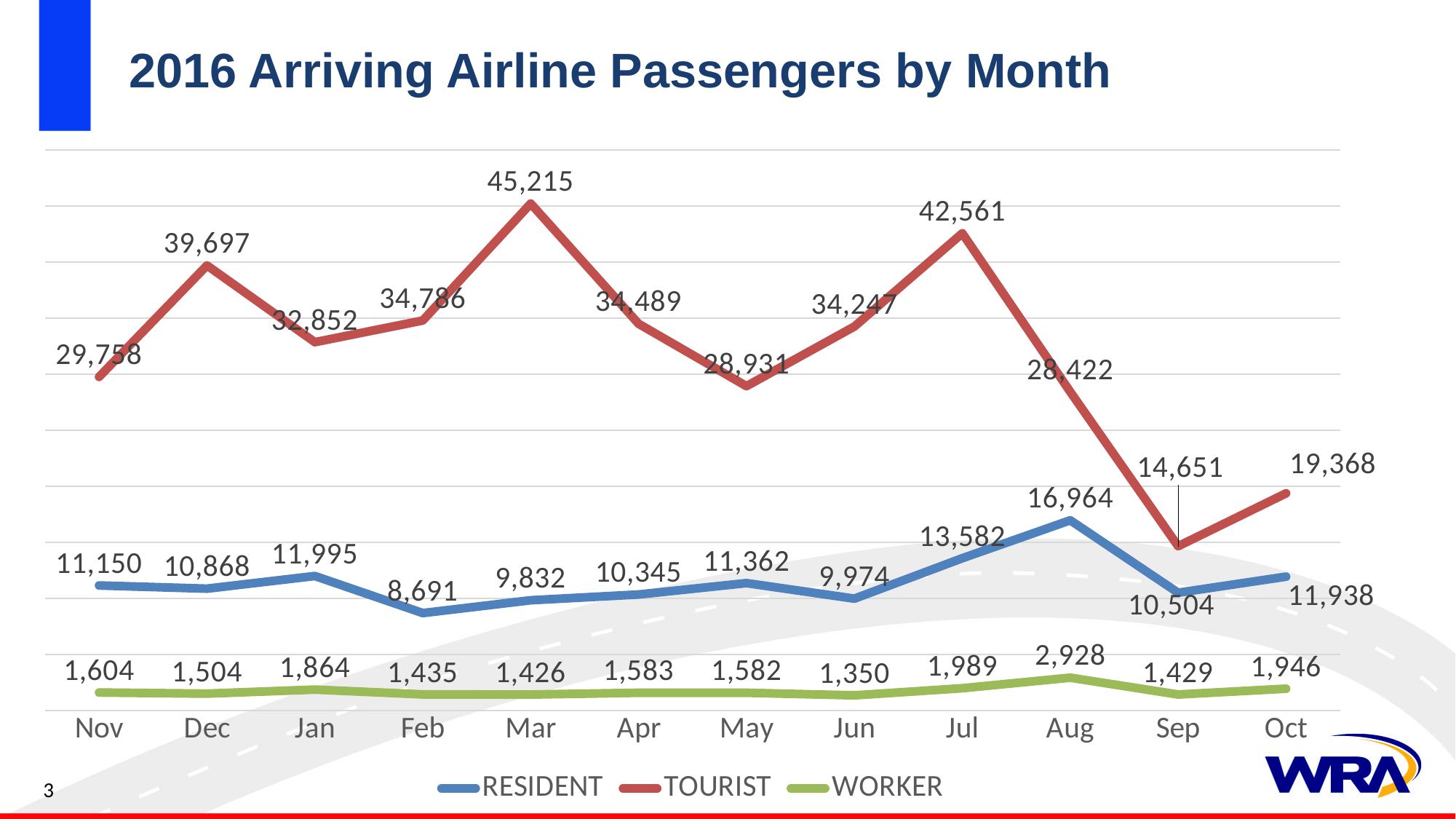
What type of chart is shown on the slide? Line chart What is the difference between the TOURIST values for Jul and Aug? 14,139 In which month is the TOURIST value highest? Mar What is the RESIDENT value for Aug? 16,964 Does the TOURIST line rise or fall from Aug to Sep? Fall In which month is the TOURIST value lowest? Sep In which month is the WORKER value highest? Aug What is the TOURIST value for Mar? 45,215 How many series does the legend list? 3 How many months are plotted along the x axis? 12 Which is larger, the RESIDENT value for Jul or the TOURIST value for Sep? TOURIST value for Sep What is the WORKER value for Jun? 1,350